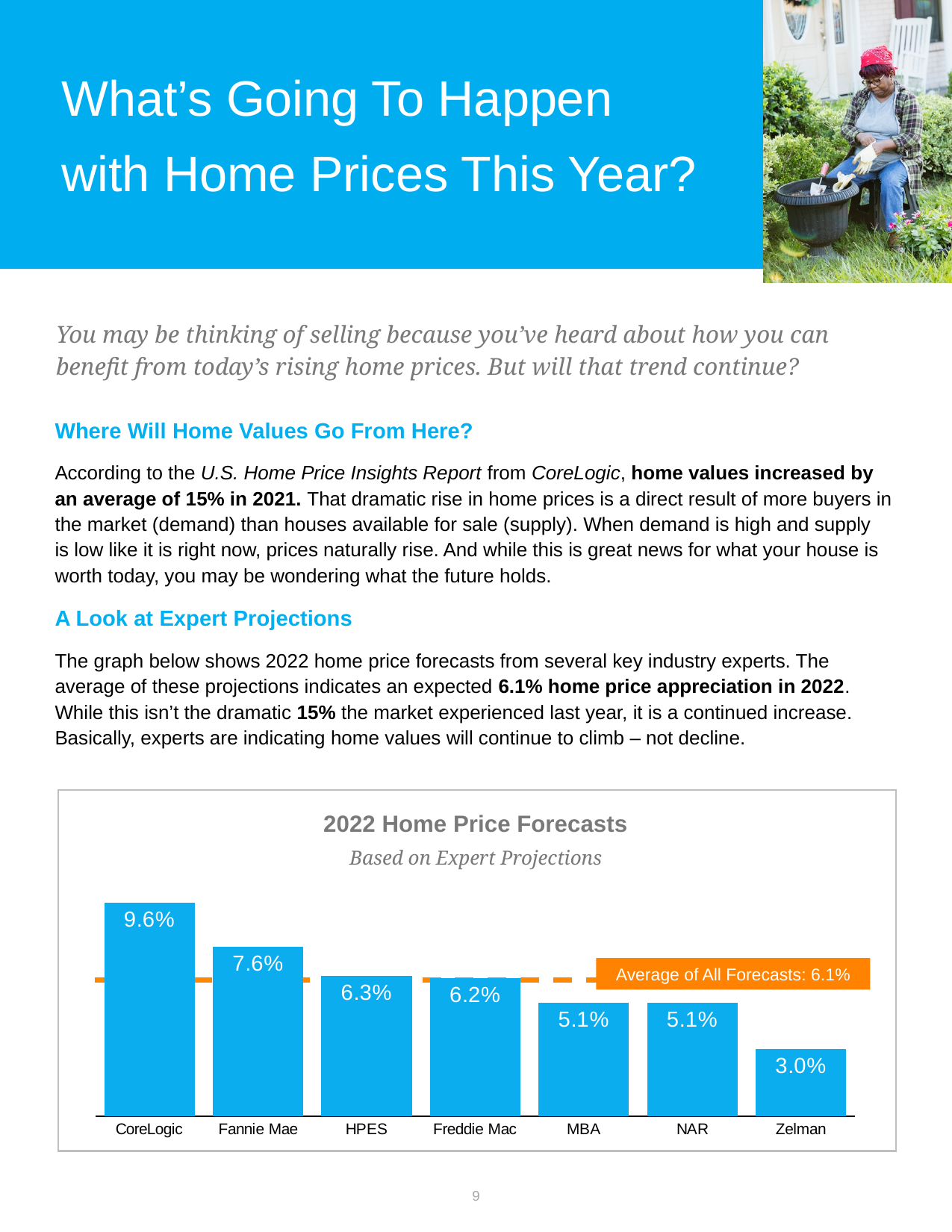
What is the difference between the CoreLogic and Fannie Mae forecasts? 2.0% What is the 2022 home price forecast from CoreLogic? 9.6% What is the average of all forecasts shown on the chart? 6.1% Which forecast is larger, HPES or MBA? HPES Which forecaster has the lowest 2022 home price forecast? Zelman Do the forecast values rise or fall moving from left to right across the chart? Fall What is the title of the chart? 2022 Home Price Forecasts What kind of chart is used to show the 2022 home price forecasts? Bar chart What is the forecast value shown for Zelman? 3.0% Which forecaster has the highest 2022 home price forecast? CoreLogic How many forecasters are shown in the chart? 7 What is the forecast value shown for Freddie Mac? 6.2%